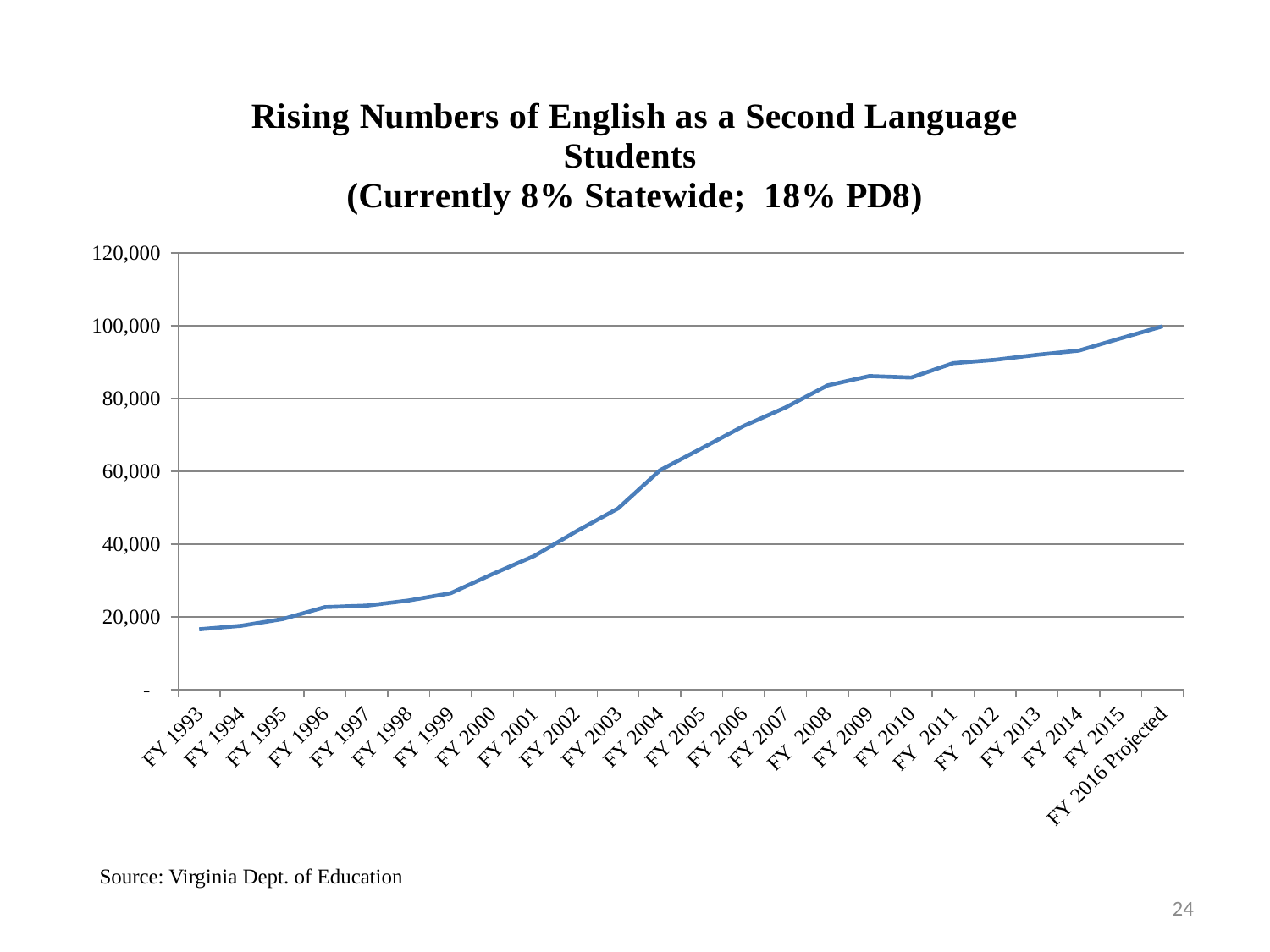
How many fiscal years are plotted along the x axis? 24 Is the value for FY 1993 greater or less than 20,000? less Which is larger, the value for FY 2005 or the value for FY 2003? FY 2005 Which fiscal year has the highest number of ESL students? FY 2016 Projected Is the value for FY 2006 greater or less than 60,000? greater What kind of chart is shown on the slide? line chart Is the value for FY 2008 greater or less than 80,000? greater What is the title of the chart? Rising Numbers of English as a Second Language Students (Currently 8% Statewide; 18% PD8) Do the values rise or fall from FY 1993 to FY 2016 Projected? rise Which fiscal year has the lowest number of ESL students? FY 1993